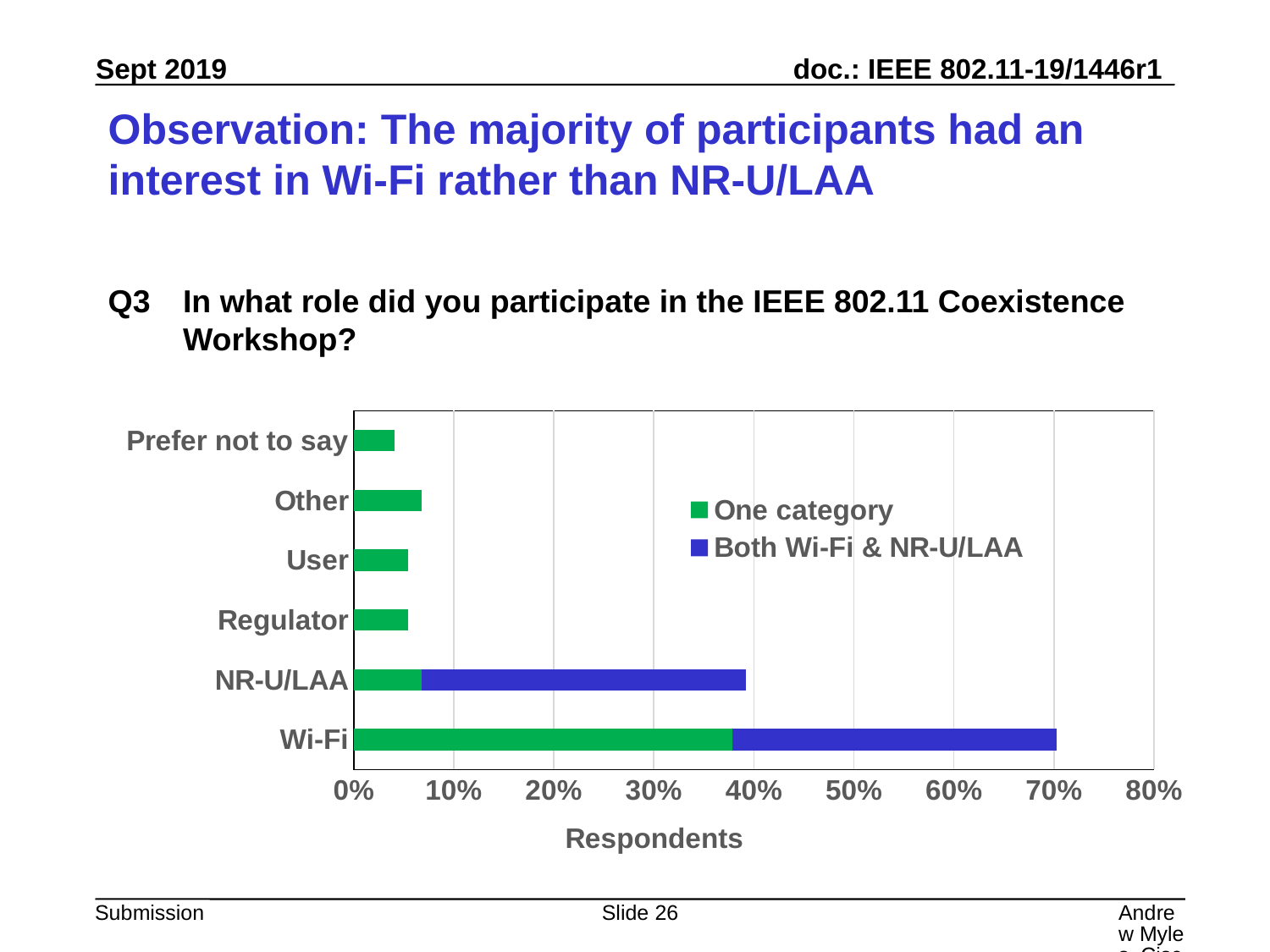
Which bar is longer, Other or Prefer not to say? Other How many categories are shown on the vertical axis of the chart? 6 Is the value for Other greater or less than 10%? less Is the total value for Wi-Fi greater or less than 60%? greater Which category has the shortest bar in the chart? Prefer not to say What is the title of the horizontal axis of the chart? Respondents Which category has the longest bar in the chart? Wi-Fi Is the total value for NR-U/LAA greater or less than 30%? greater What are the two series names listed in the chart legend? One category; Both Wi-Fi & NR-U/LAA Which bar is longer, Wi-Fi or NR-U/LAA? Wi-Fi How many series does the chart legend list? 2 What kind of chart is shown on the slide? bar chart